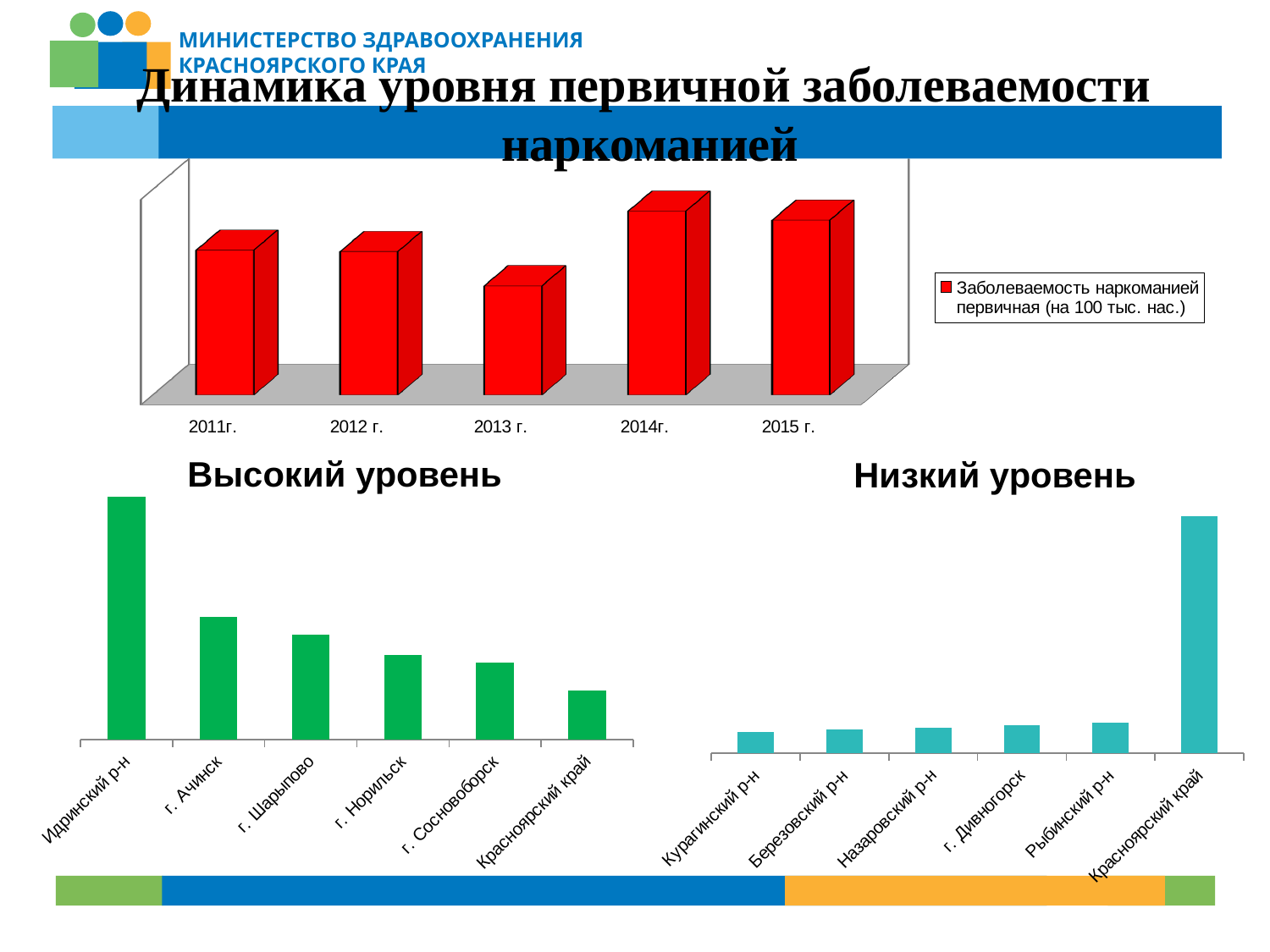
In the bottom-left chart "Высокий уровень", do the values rise or fall from left to right along the x axis? fall In the top chart titled "Динамика уровня первичной заболеваемости наркоманией", how many years are shown on the x axis? 5 In the top chart titled "Динамика уровня первичной заболеваемости наркоманией", which year has the highest value? 2014г. In the top chart titled "Динамика уровня первичной заболеваемости наркоманией", how many series does the legend list? 1 What kind of chart is the bottom-right chart "Низкий уровень"? bar chart In the top chart titled "Динамика уровня первичной заболеваемости наркоманией", which is larger, the value for 2013 г. or the value for 2014г.? 2014г. In the top chart titled "Динамика уровня первичной заболеваемости наркоманией", what is the legend entry? Заболеваемость наркоманией первичная (на 100 тыс. нас.) In the bottom-left chart "Высокий уровень", which category has the highest value? Идринский р-н In the bottom-left chart "Высокий уровень", which category has the lowest value? Красноярский край In the bottom-right chart "Низкий уровень", which category has the highest value? Красноярский край In the bottom-left chart "Высокий уровень", how many categories are shown? 6 In the top chart titled "Динамика уровня первичной заболеваемости наркоманией", which year has the lowest value? 2013 г.